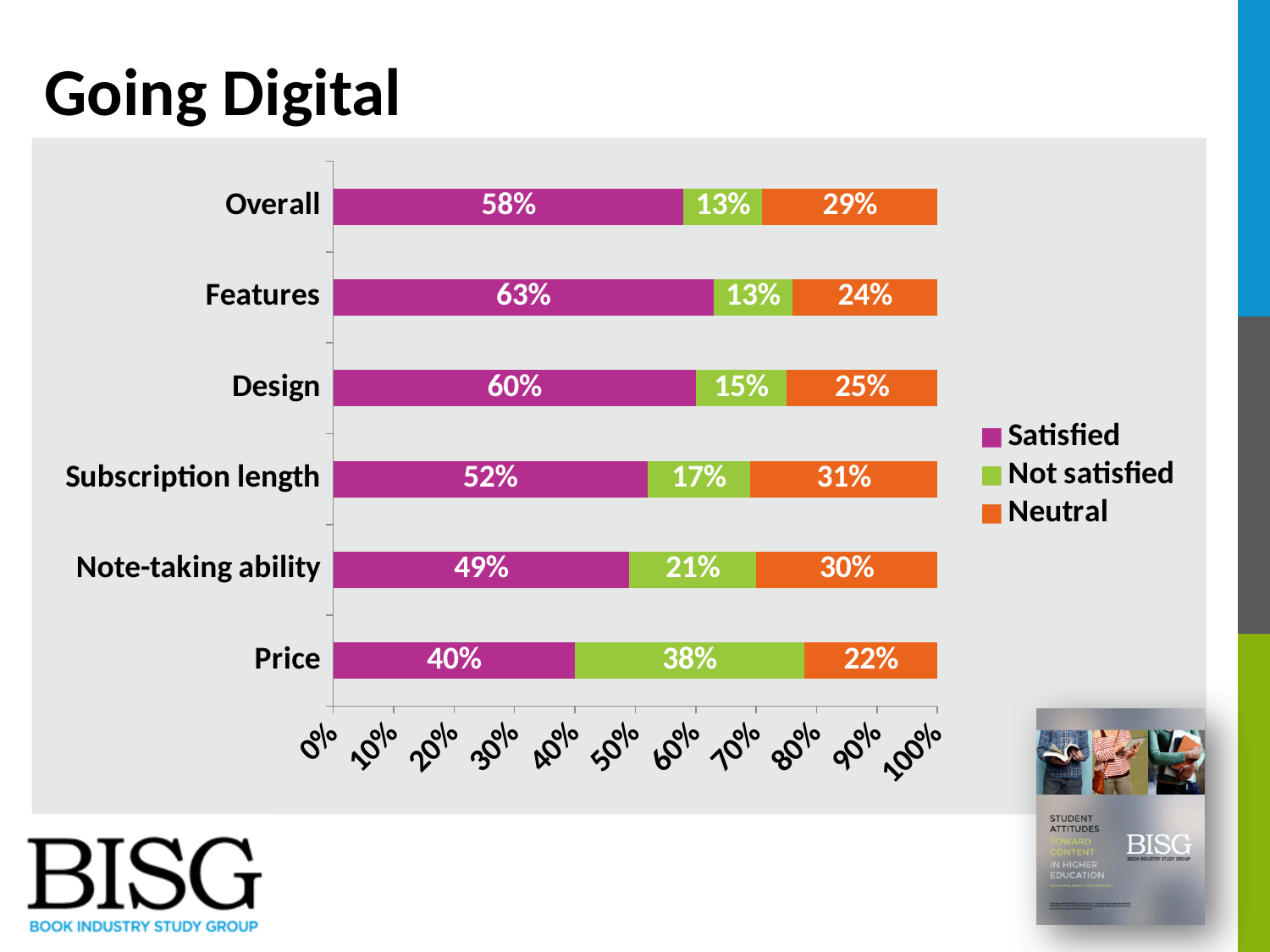
What percentage of respondents were satisfied with Price? 40% What is the Not satisfied value for Note-taking ability? 21% Which category has the lowest Satisfied percentage? Price What is the Neutral value for Subscription length? 31% Which category has the highest Not satisfied percentage? Price Which category has the highest Satisfied percentage? Features Which is larger, the Neutral value for Overall or the Neutral value for Design? Overall How many series does the legend list? 3 How many categories are shown on the chart? 6 Which colour represents the Neutral series? Orange What kind of chart is shown on the slide? Stacked bar chart What is the difference between the Satisfied percentages for Features and Price? 23%